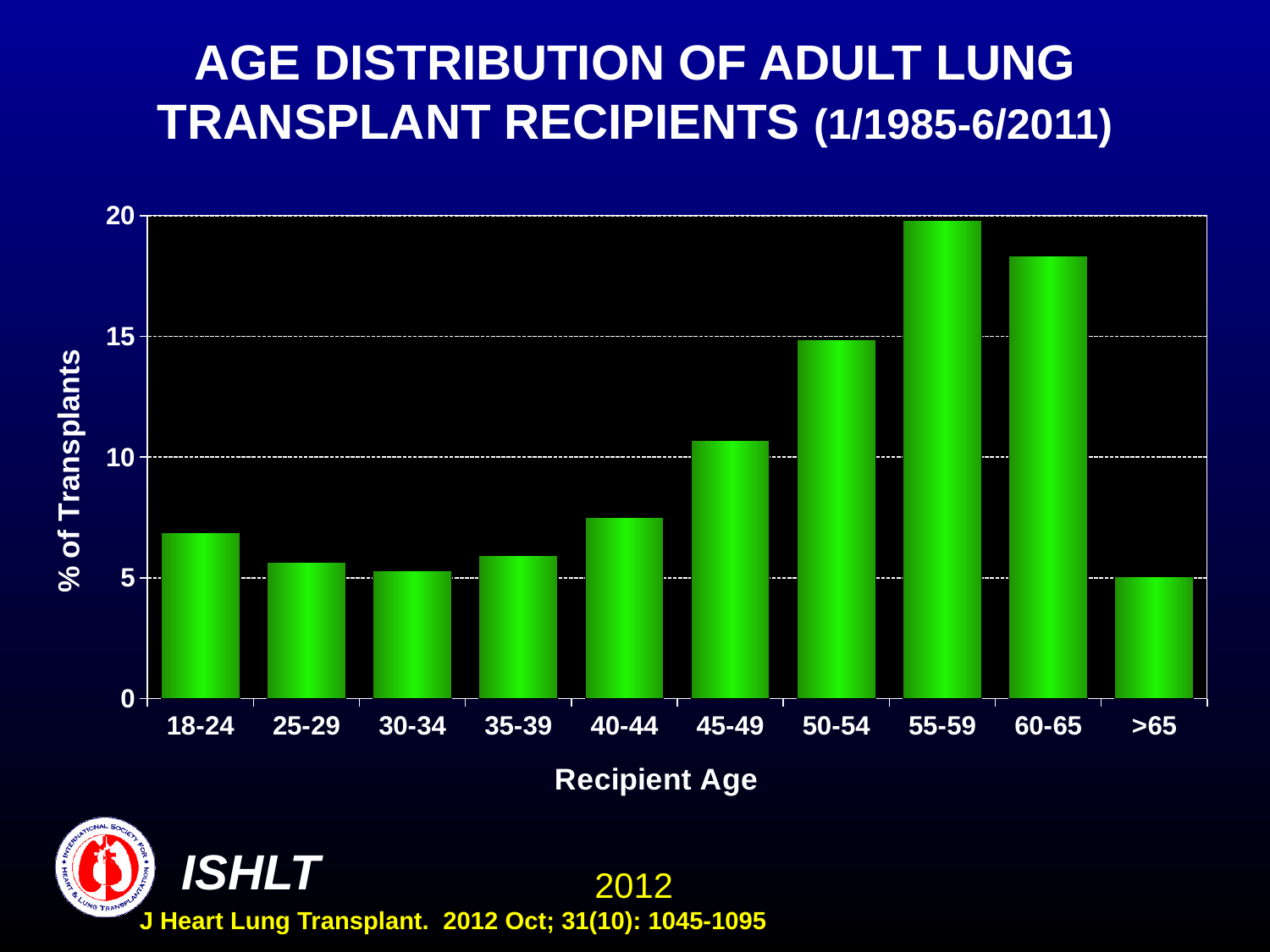
How many age categories are shown on the x axis? 10 What kind of chart is shown on the slide? bar chart Is the value for the 40-44 age group greater or less than 10? less Which recipient age group has the highest % of transplants? 55-59 What is the label of the y axis? % of Transplants Is the value for the 60-65 age group greater or less than 15? greater Which has a higher % of transplants, the 18-24 group or the 25-29 group? 18-24 Is the value for the 18-24 age group greater or less than 5? greater Do the values rise or fall from the 35-39 group to the 55-59 group? rise Which has a higher % of transplants, the 50-54 group or the 60-65 group? 60-65